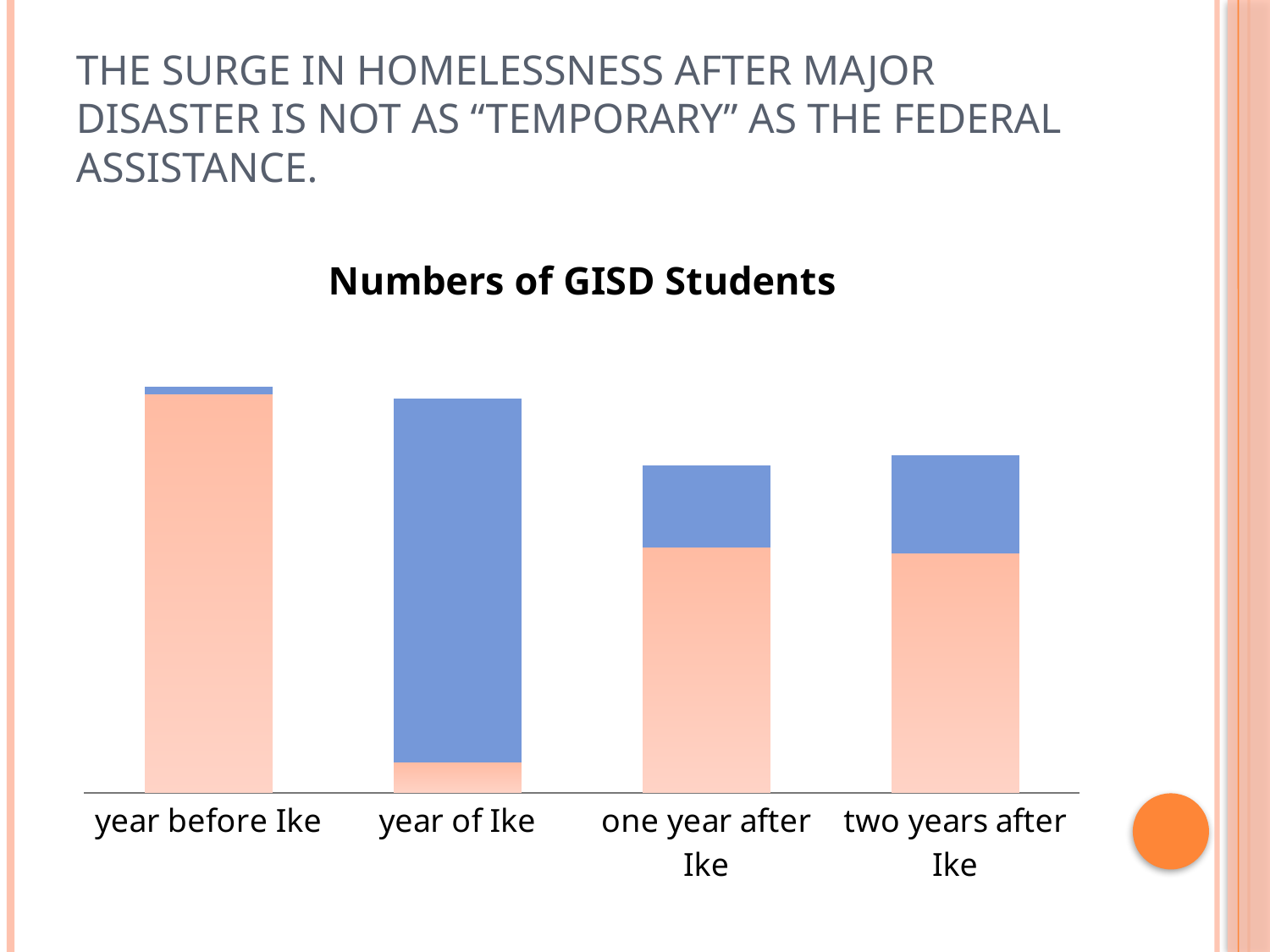
Which category has the largest blue segment in the chart? year of Ike Is the orange segment for 'year before Ike' larger or smaller than the orange segment for 'one year after Ike'? larger What type of chart is shown on the slide? stacked bar chart Does the total bar height rise or fall from 'year of Ike' to 'one year after Ike'? fall Is the blue segment for 'year of Ike' larger or smaller than the blue segment for 'two years after Ike'? larger Which category has the smallest blue segment in the chart? year before Ike What is the title of the chart? Numbers of GISD Students Which category has the smallest orange segment in the chart? year of Ike How many categories are shown along the x axis of the chart? 4 Is the total bar for 'year of Ike' taller or shorter than the total bar for 'one year after Ike'? taller How many colours (series) are stacked in each bar of the chart? 2 Which category has the largest orange segment in the chart? year before Ike